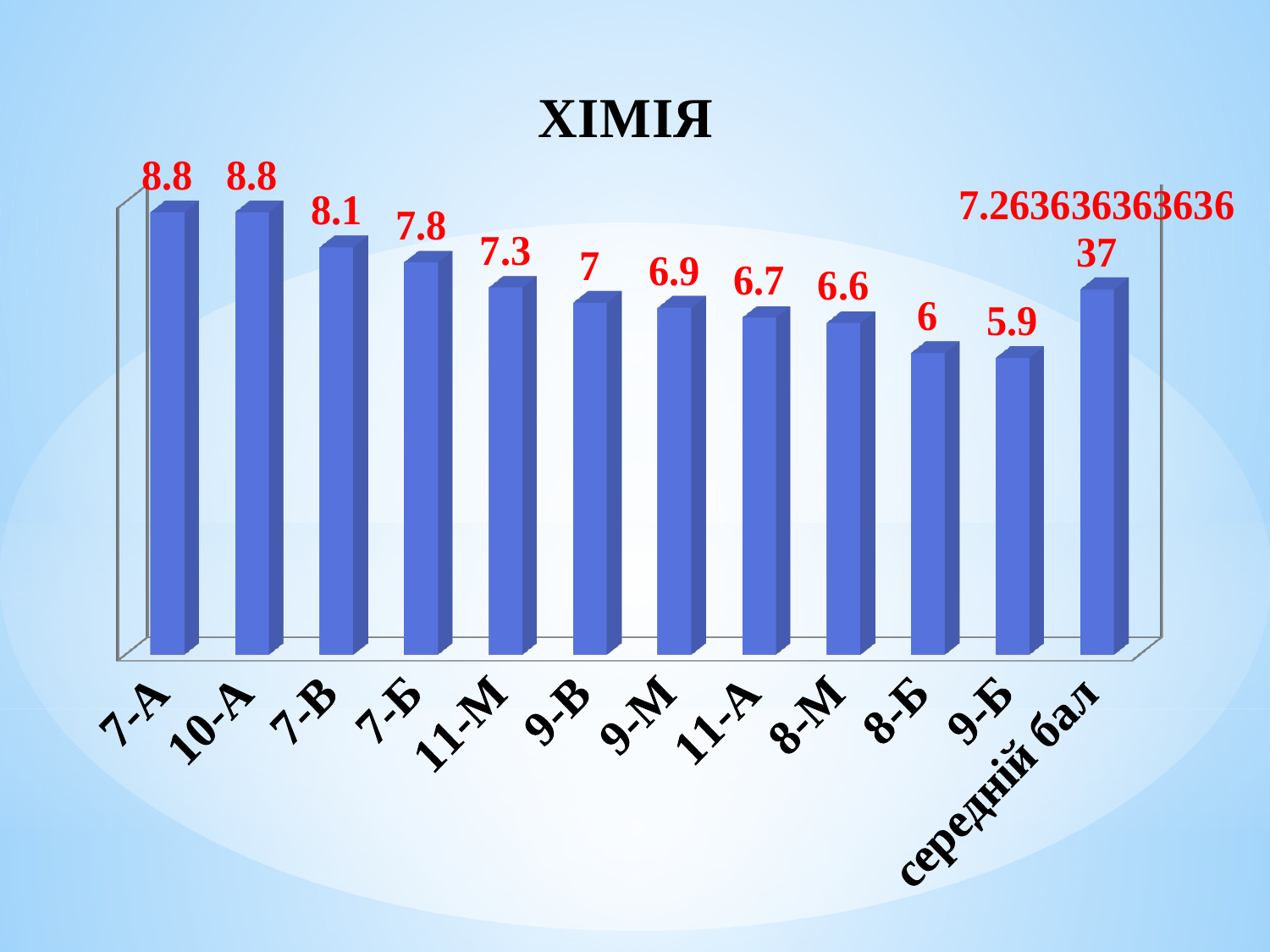
What is the title of the chart? ХІМІЯ What is the value for 9-Б? 5.9 What is the value for 7-В? 8.1 What is the difference between the values for 7-А and 9-Б? 2.9 How many bars are shown in the chart? 12 What kind of chart is shown on the slide? Bar chart What is the value for 9-М? 6.9 What is the value for 8-Б? 6 What is the difference between the values for 7-В and 7-Б? 0.3 Which is larger, the value for 11-А or the value for 8-М? 11-А What is the value for 11-М? 7.3 Which category has the lowest value? 9-Б